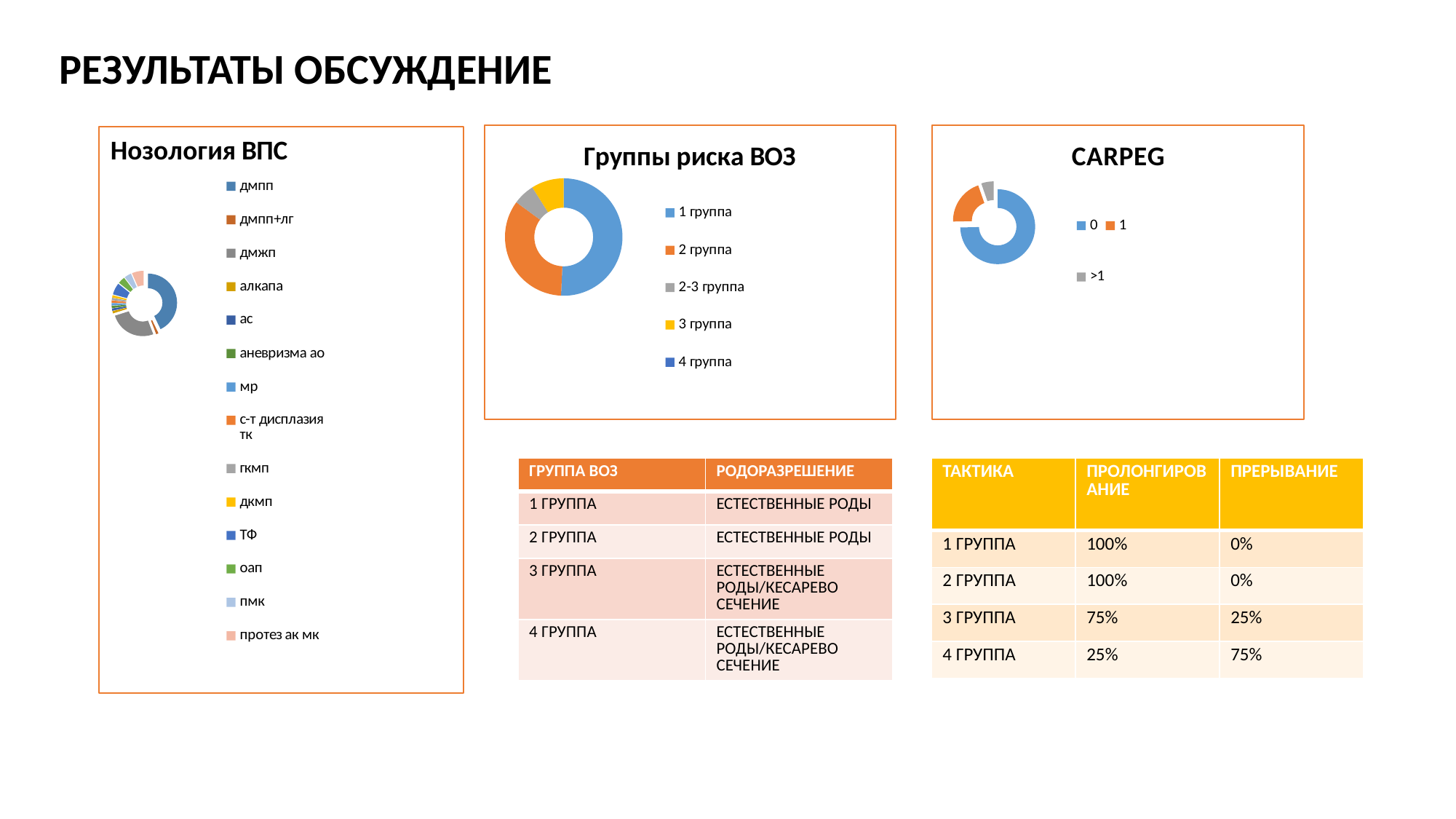
How many categories does the legend of the "Нозология ВПС" chart list? 14 In the "Группы риска ВОЗ" chart, which category has the largest slice? 1 группа In the "Группы риска ВОЗ" chart, which slice is larger: 2 группа or 3 группа? 2 группа What colour is the "2 группа" slice in the "Группы риска ВОЗ" chart? Orange In the "CARPEG" chart, which category has the smallest slice? >1 In the "CARPEG" chart, which slice is larger: 1 or >1? 1 How many categories does the legend of the "Группы риска ВОЗ" chart list? 5 What kind of chart is the "Группы риска ВОЗ" chart? Doughnut chart In the "CARPEG" chart, which category has the largest slice? 0 In the "Нозология ВПС" chart, which category has the largest slice? дмпп What kind of chart is the "CARPEG" chart? Doughnut chart How many categories does the legend of the "CARPEG" chart list? 3